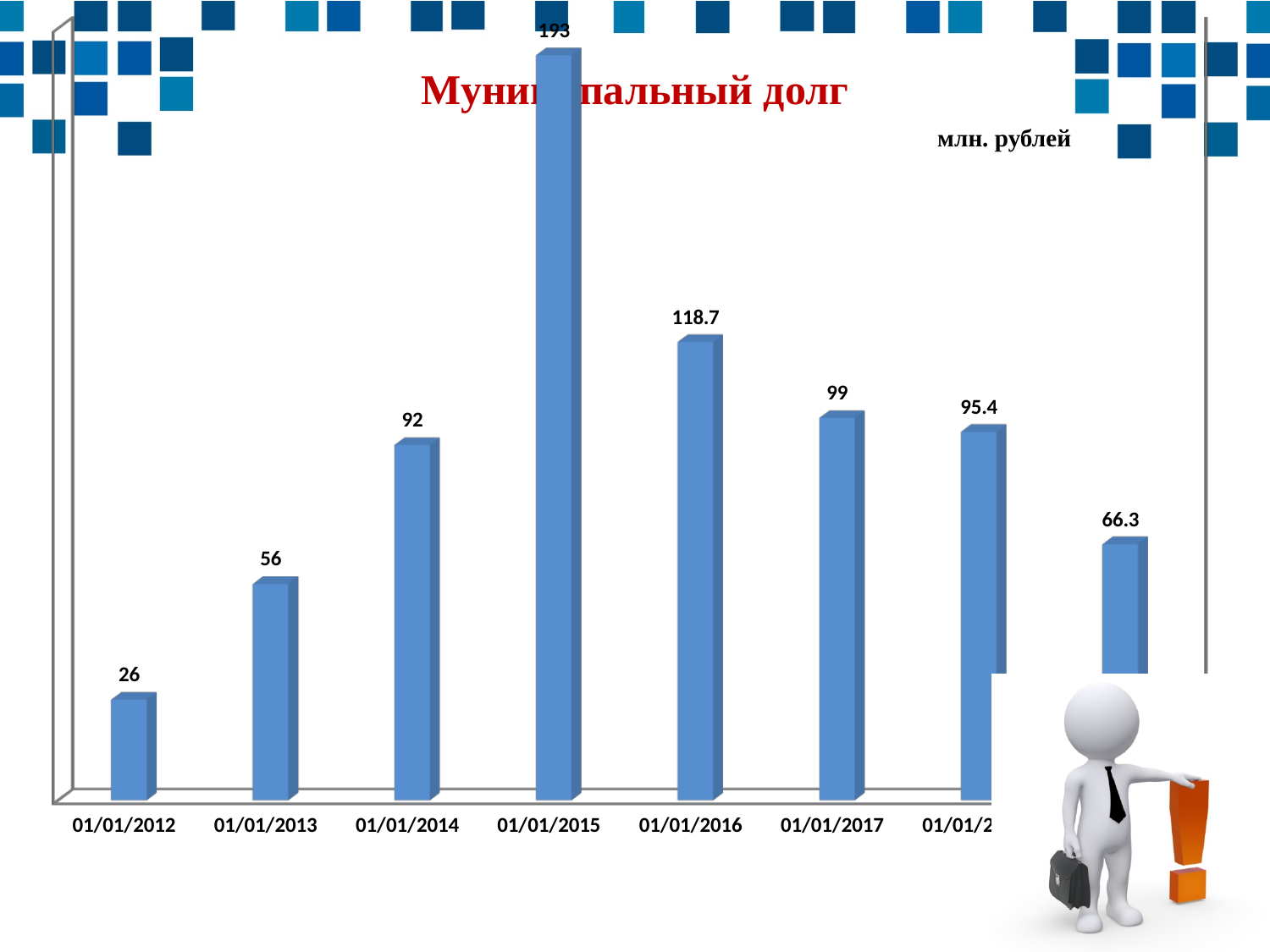
What kind of chart is shown on the slide? bar chart How many bars are plotted on the chart? 8 What is the value for 01/01/2016? 118.7 What is the difference between the values for 01/01/2014 and 01/01/2013? 36 What is the value for 01/01/2012? 26 What is the value for 01/01/2015? 193 Which date has the highest value? 01/01/2015 Which is larger, the value for 01/01/2013 or the value for 01/01/2014? 01/01/2014 Which date has the lowest value? 01/01/2012 Do the values rise or fall from 01/01/2012 to 01/01/2015? rise What is the difference between the values for 01/01/2015 and 01/01/2016? 74.3 What is the value for 01/01/2017? 99